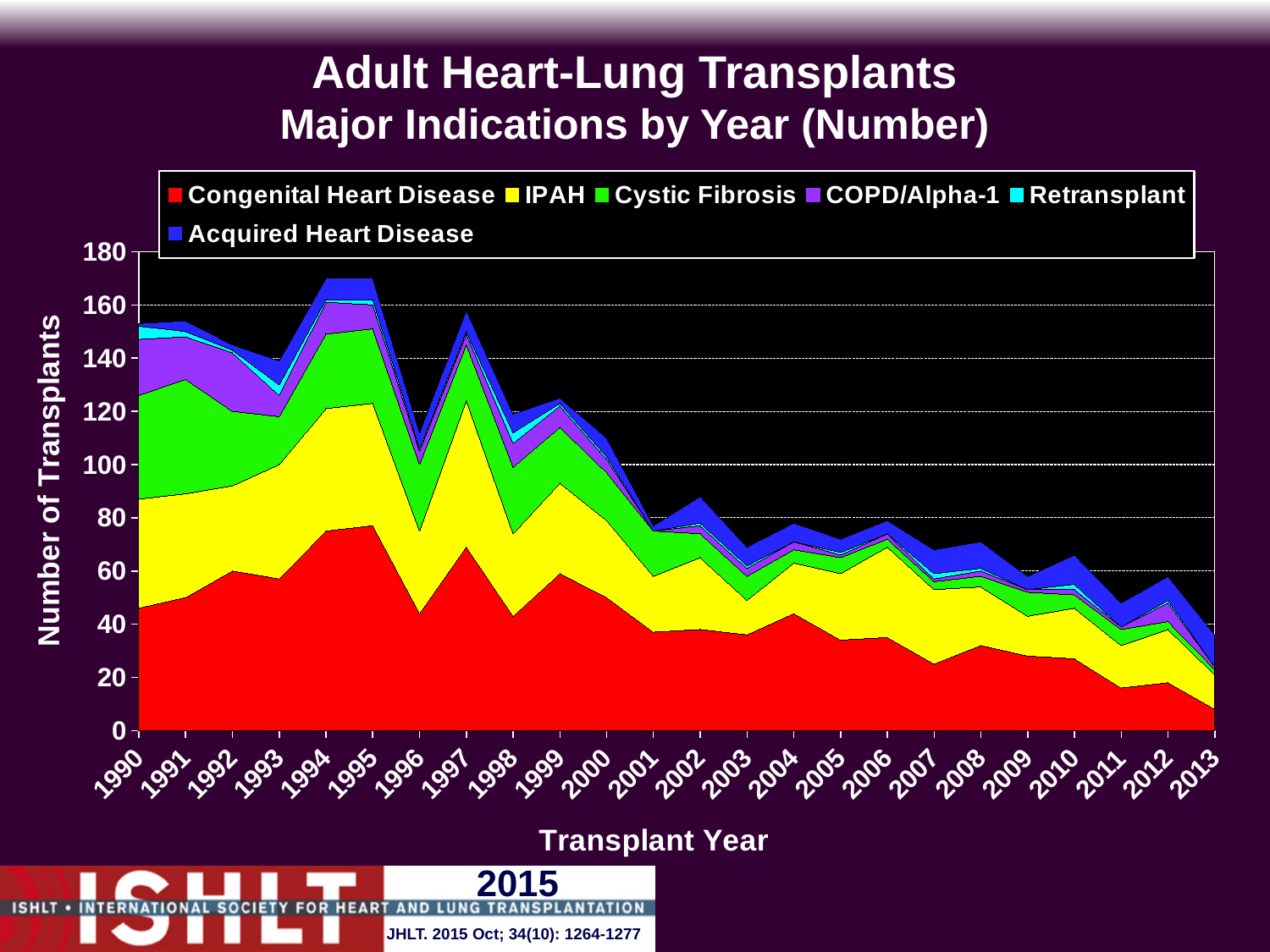
Is the number of Congenital Heart Disease transplants in 1990 greater or less than 40? greater Is the total number of transplants in 2008 greater or less than 80? less Which year has the lowest total number of transplants? 2013 What kind of chart is shown on the slide? Stacked area chart How many series does the legend list? 6 Which is larger, the total number of transplants in 1994 or in 2004? 1994 Overall, do total transplant numbers rise or fall from 1990 to 2013? fall Is the total number of transplants in 1994 greater or less than 160? greater What is the title of the chart? Adult Heart-Lung Transplants Major Indications by Year (Number) How many transplant years are shown along the x axis? 24 What is the label of the y axis? Number of Transplants